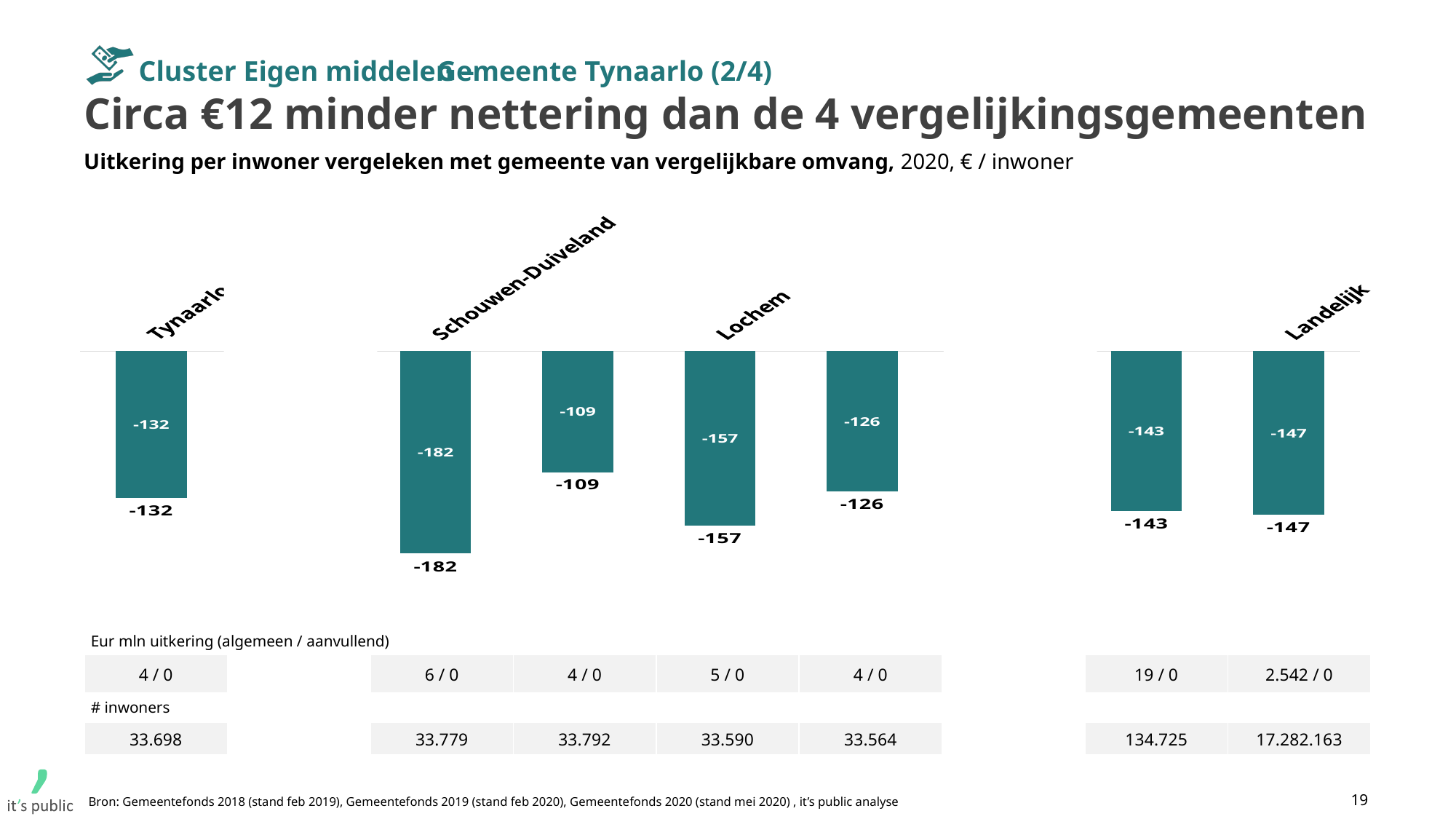
What is the value for Landelijk? -147 Which labelled category has the highest (least negative) value? Tynaarlo What is the value for Tynaarlo? -132 What kind of chart is shown on the slide? Bar chart What is the value for Lochem? -157 What is the difference between the values for Schouwen-Duiveland and Lochem? 25 How many bars are plotted in the chart? 7 What is the difference between the values for Tynaarlo and Landelijk? 15 What is the number of inhabitants (# inwoners) shown for Tynaarlo? 33.698 What is the value for Schouwen-Duiveland? -182 Which is larger, the value for Tynaarlo or the value for Lochem? Tynaarlo Which labelled category has the lowest (most negative) value? Schouwen-Duiveland